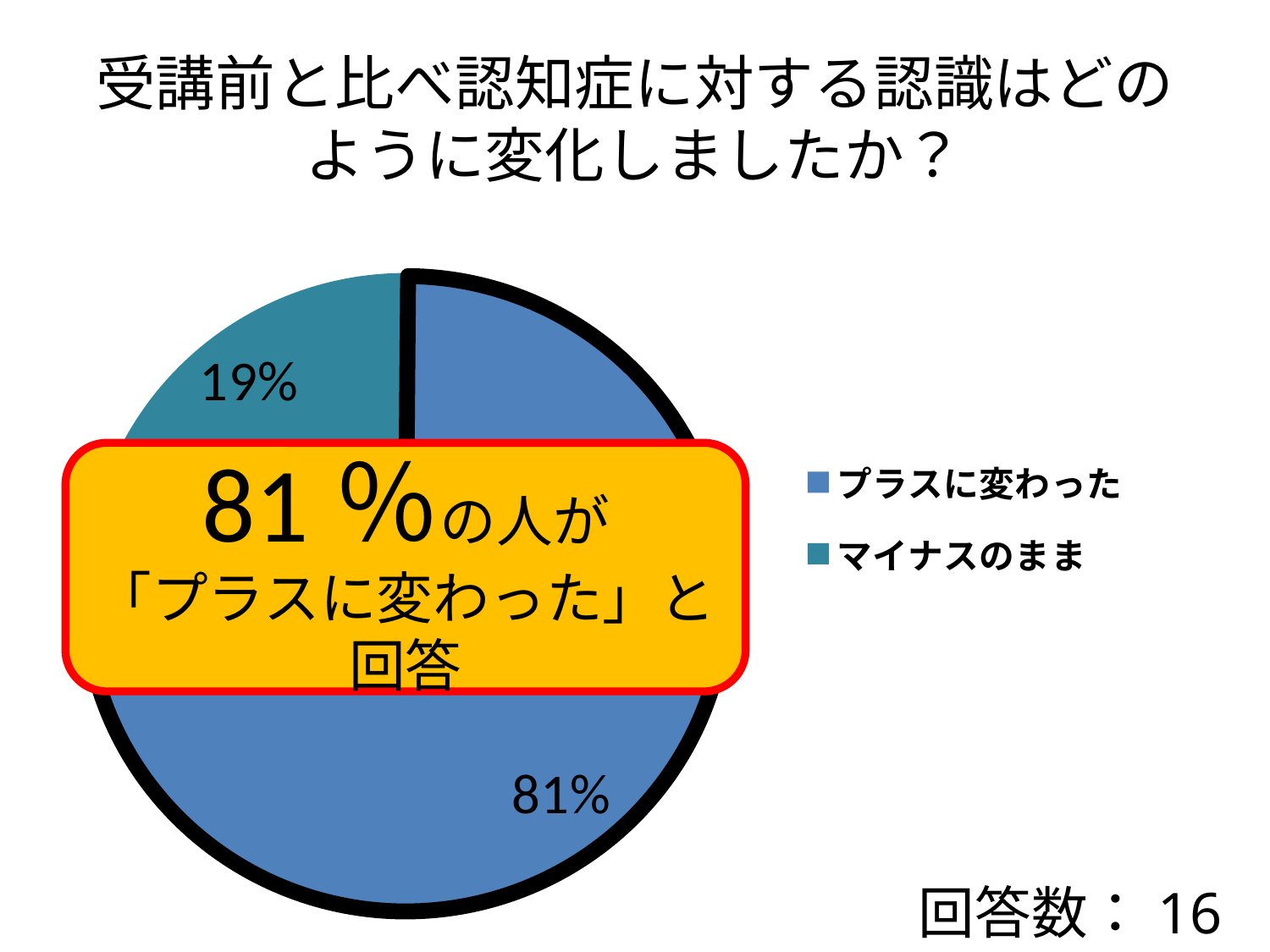
What is the difference in percentage points between 「プラスに変わった」 and 「マイナスのまま」? 62 Which category has the smallest slice of the pie? マイナスのまま What share of the pie does 「マイナスのまま」 take? 19% What is the number of responses (回答数) shown on the slide? 16 Which is larger, the slice for 「プラスに変わった」 or the slice for 「マイナスのまま」? プラスに変わった What is the total of the two slices shown in the pie chart? 100% How many categories does the pie chart have? 2 Which legend entry is shown in the darker teal colour? マイナスのまま What share of the pie does 「プラスに変わった」 take? 81% What kind of chart is shown on the slide? pie chart How many entries does the legend list? 2 Which category has the largest slice of the pie? プラスに変わった